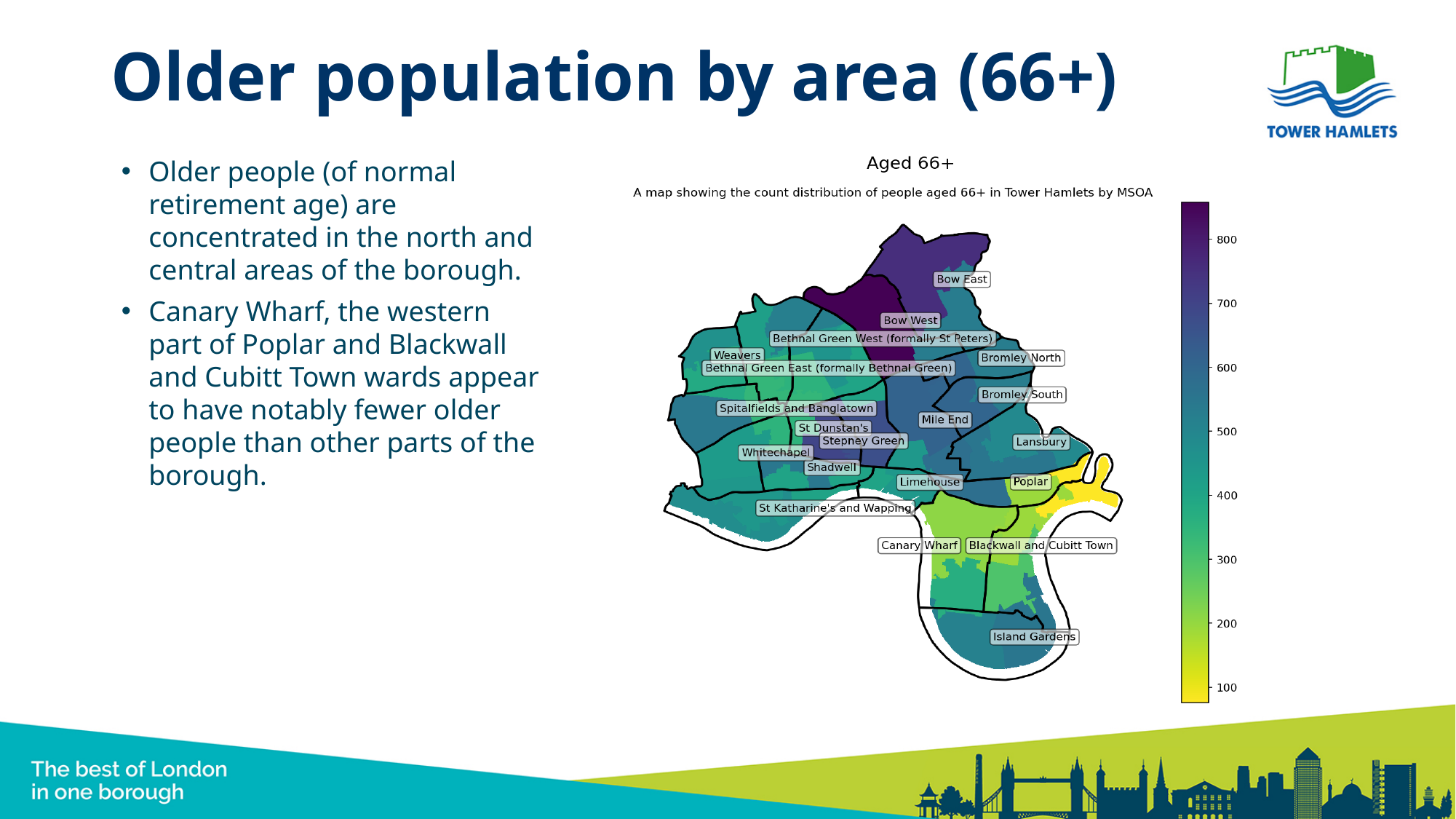
What is the lowest value labelled on the colour bar of the map? 100 According to the map's colour scale, is the count of people aged 66+ in Canary Wharf greater or less than 500? less According to the map, which area has more people aged 66+, Mile End or Canary Wharf? Mile End What is the highest value labelled on the colour bar of the map? 800 According to the map's colour scale, is the count of people aged 66+ in Bow East greater or less than 400? greater What geographic unit does the map's subtitle say the data is broken down by? MSOA What is the title of the map chart on the slide? Aged 66+ What kind of chart is shown on the slide? A map (choropleth map) According to the map, which area has fewer people aged 66+, Bow East or Blackwall and Cubitt Town? Blackwall and Cubitt Town How many numbered tick labels are shown on the map's colour bar? 8